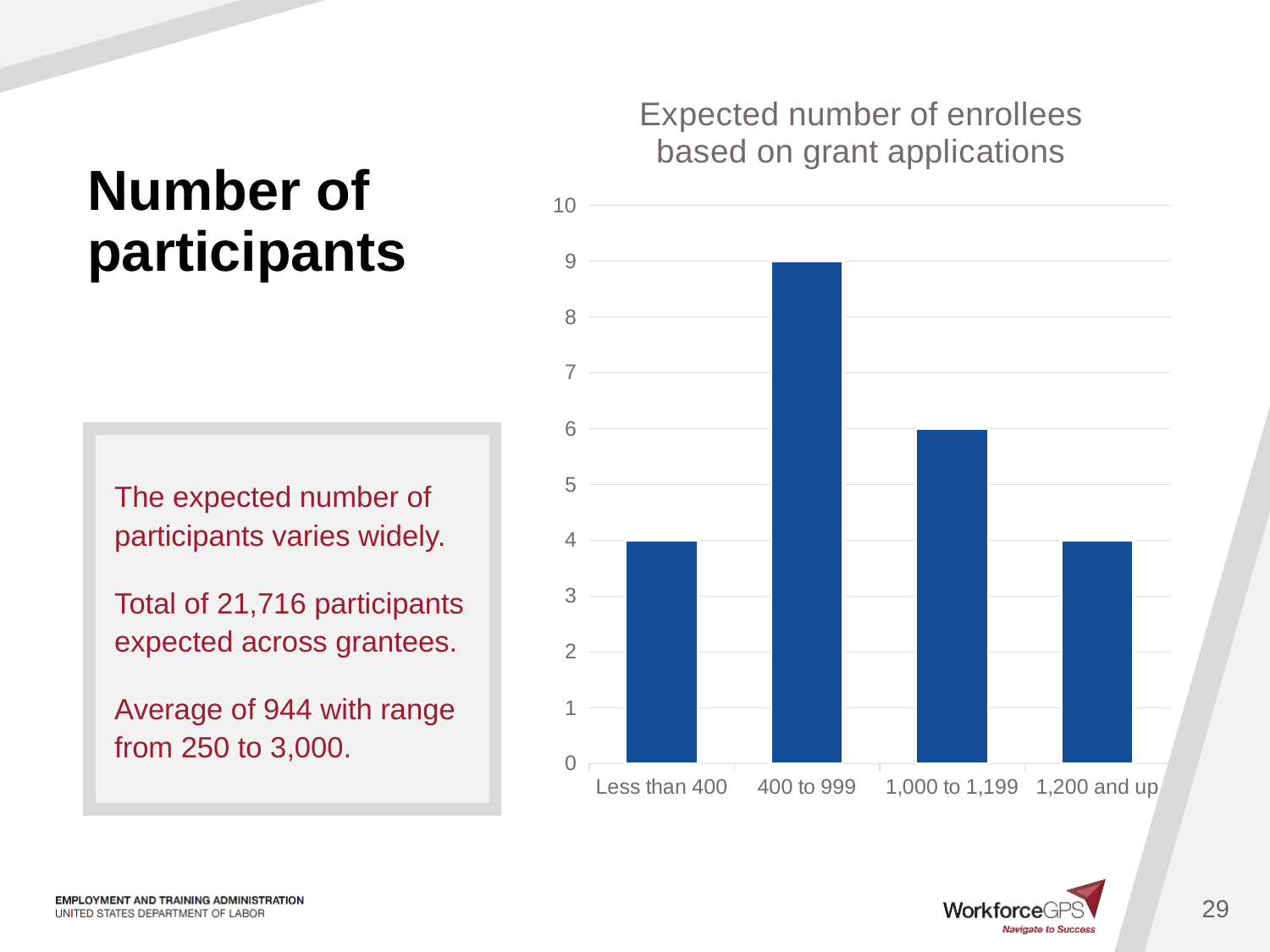
What is the value for the "1,000 to 1,199" category? 6 Which category has the highest value? 400 to 999 What is the value for the "1,200 and up" category? 4 Which is larger, the value for "1,000 to 1,199" or the value for "1,200 and up"? 1,000 to 1,199 What is the value for the "Less than 400" category? 4 How many categories are shown on the x axis of the chart? 4 What kind of chart is shown on the slide? bar chart What is the title of the chart? Expected number of enrollees based on grant applications What is the difference between the values for "400 to 999" and "1,000 to 1,199"? 3 Is the value for "400 to 999" greater or less than 8? greater What is the difference between the values for "400 to 999" and "Less than 400"? 5 What is the value for the "400 to 999" category? 9